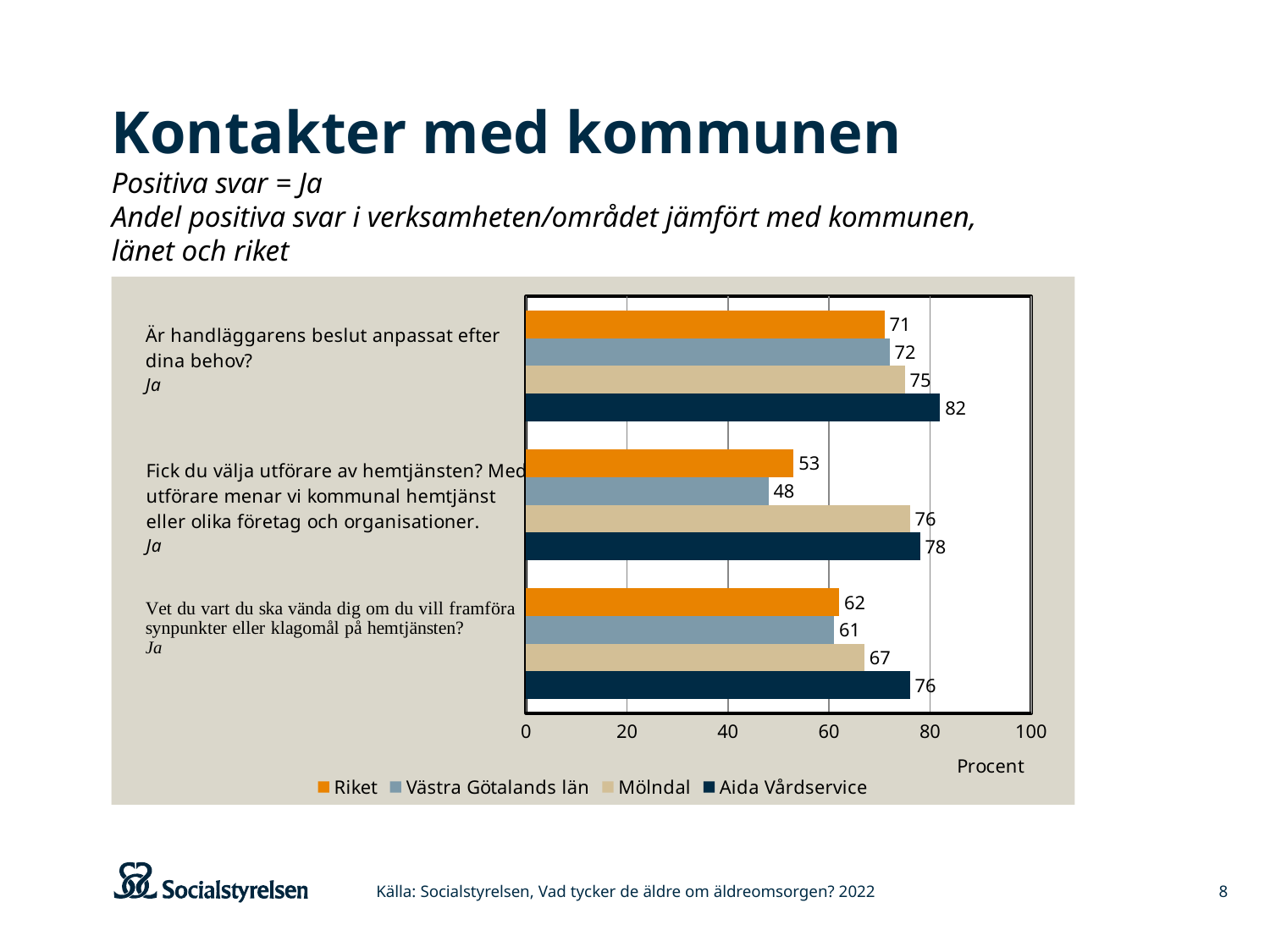
How many series does the legend list? 4 How many question categories are plotted on the chart? 3 What is the value for Västra Götalands län for "Fick du välja utförare av hemtjänsten?"? 48 For "Fick du välja utförare av hemtjänsten?", which is larger: Mölndal or Riket? Mölndal Which series has the lowest value for "Fick du välja utförare av hemtjänsten?"? Västra Götalands län Which series has the highest value for "Fick du välja utförare av hemtjänsten?"? Aida Vårdservice What is the value for Mölndal for "Vet du vart du ska vända dig om du vill framföra synpunkter eller klagomål på hemtjänsten?"? 67 What label is shown on the horizontal axis of the chart? Procent What type of chart is shown on the slide? Bar chart What is the value for Aida Vårdservice for "Är handläggarens beslut anpassat efter dina behov?"? 82 What is the difference between Aida Vårdservice and Riket for "Vet du vart du ska vända dig om du vill framföra synpunkter eller klagomål på hemtjänsten?"? 14 Is the value for Riket for "Fick du välja utförare av hemtjänsten?" greater or less than 60? less